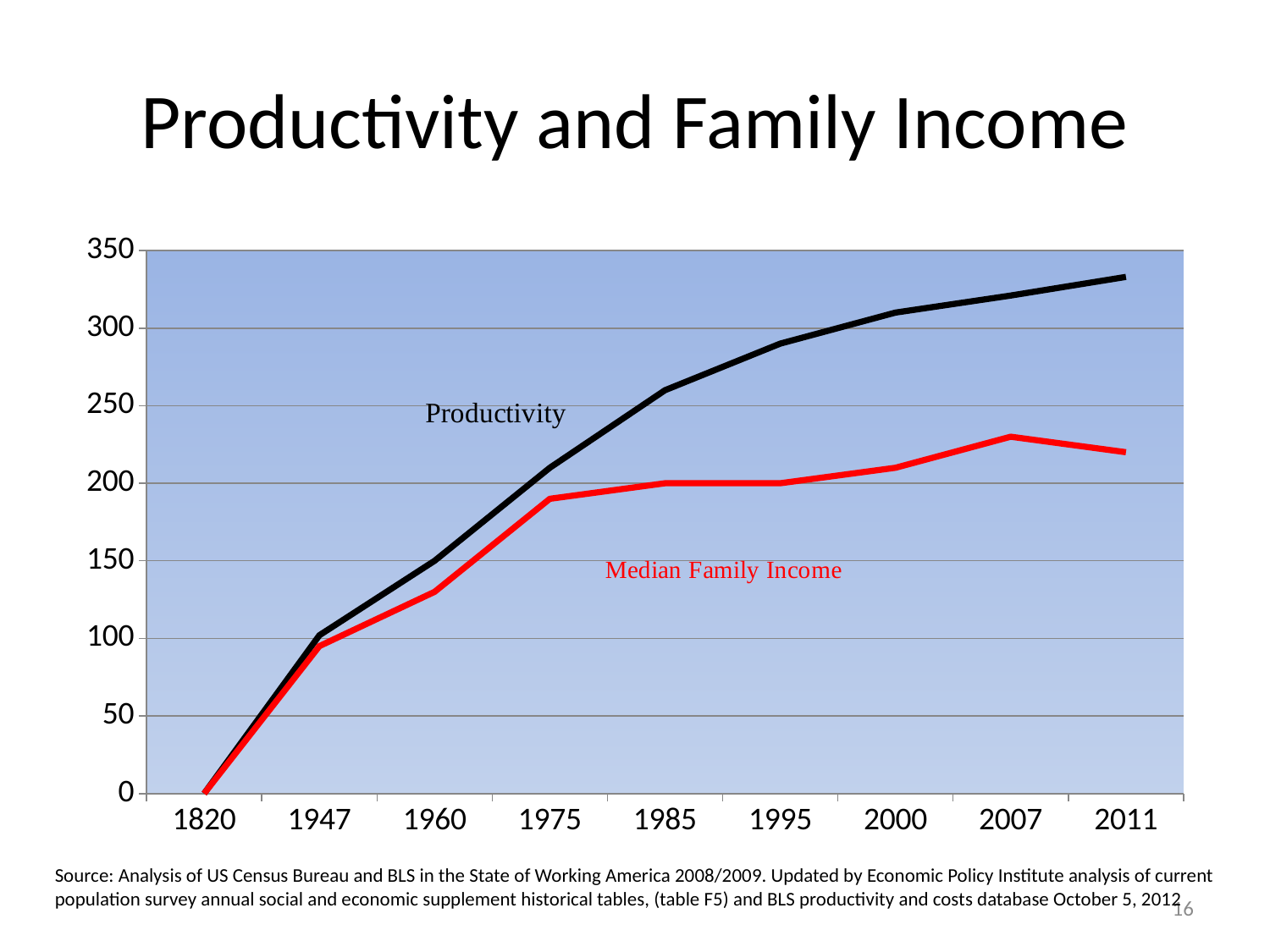
In which year does Median Family Income reach its highest value? 2007 Is the value for Median Family Income in 2011 greater or less than 250? less How many years are labelled on the x axis of the chart? 9 What kind of chart is shown on the slide? line chart Does Productivity rise or fall from 1820 to 2011? rise What is the value of Productivity in 1820? 0 In 2011, which is larger, Productivity or Median Family Income? Productivity Is the value for Productivity in 2011 greater or less than 300? greater How many series are plotted on the chart? 2 Is the value for Productivity in 1995 greater or less than 300? less What colour is the Median Family Income line? red